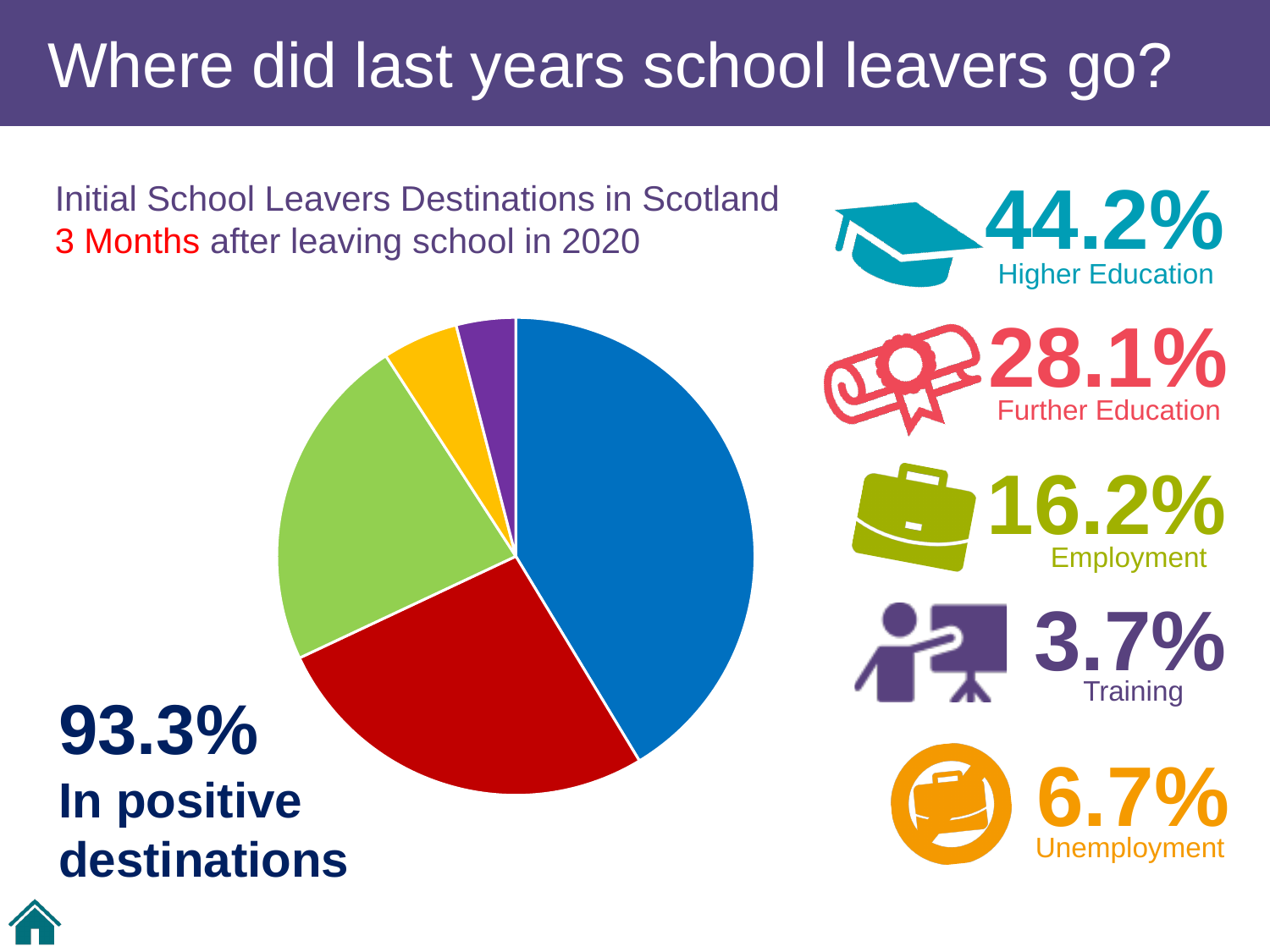
Which destination has the largest share of the pie? Higher Education Which is larger, the share for Employment or the share for Unemployment? Employment What colour is the Higher Education slice of the pie? Blue What is the difference between the Higher Education and Further Education percentages? 16.1% What percentage of school leavers were in Unemployment? 6.7% What percentage of school leavers went into Higher Education? 44.2% What kind of chart is shown on the slide? Pie chart What percentage of school leavers went into Training? 3.7% What percentage of school leavers went into Further Education? 28.1% What percentage of school leavers went into Employment? 16.2% How many slices does the pie chart have? 5 Which destination has the smallest share of the pie? Training